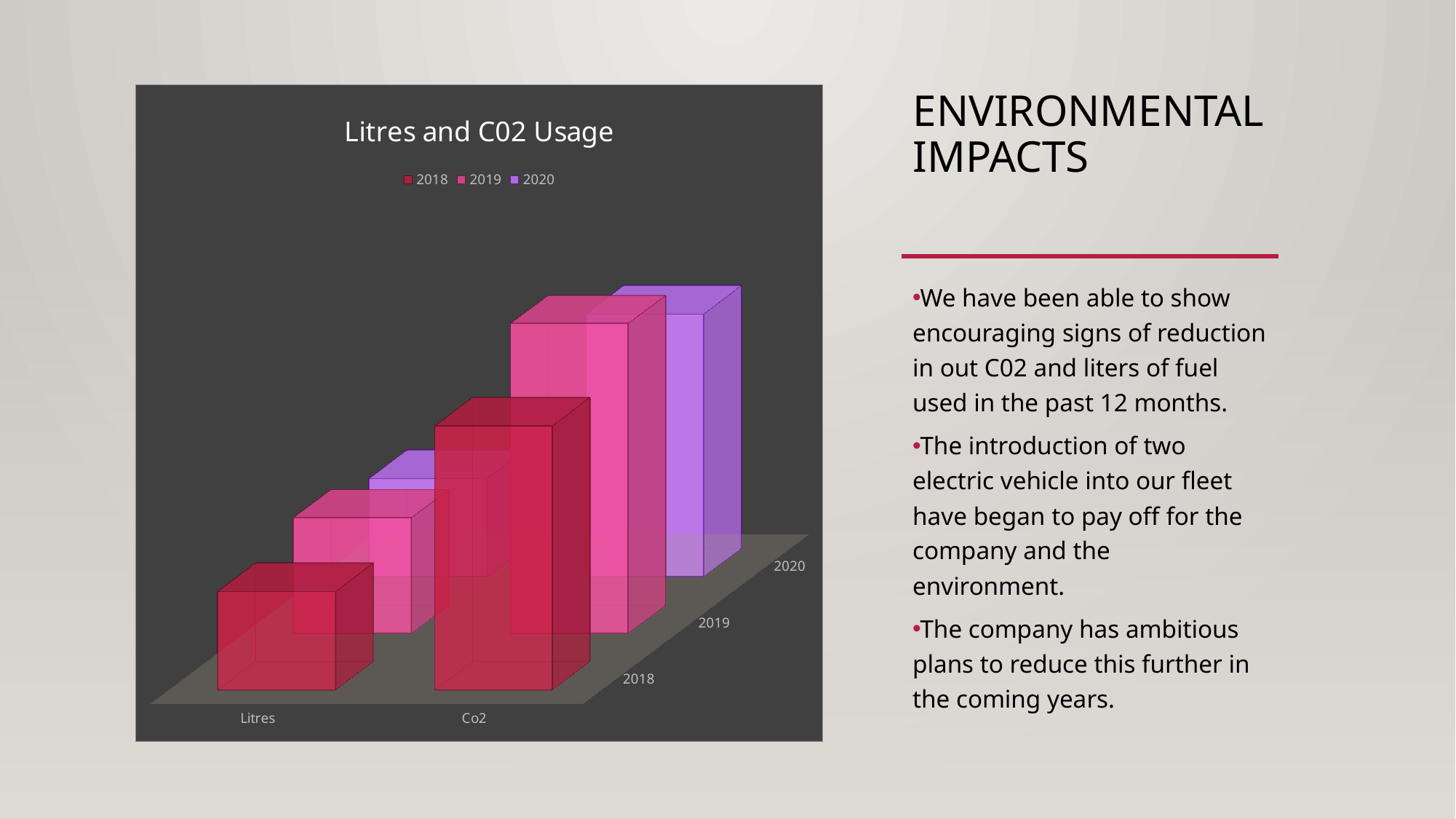
For the 2020 series, which category has the taller bar, Litres or Co2? Co2 For the 2019 series, which category has the taller bar, Litres or Co2? Co2 What kind of chart is shown on the slide? bar chart Which category has the shortest bar for the 2018 series? Litres Which category has the shortest bar for the 2020 series? Litres How many categories are shown on the chart's category axis? 2 For the 2018 series, which category has the taller bar, Litres or Co2? Co2 Which category has the tallest bar for the 2019 series? Co2 What is the title of the chart? Litres and C02 Usage How many series does the chart's legend list? 3 Which series are listed in the chart's legend? 2018, 2019, 2020